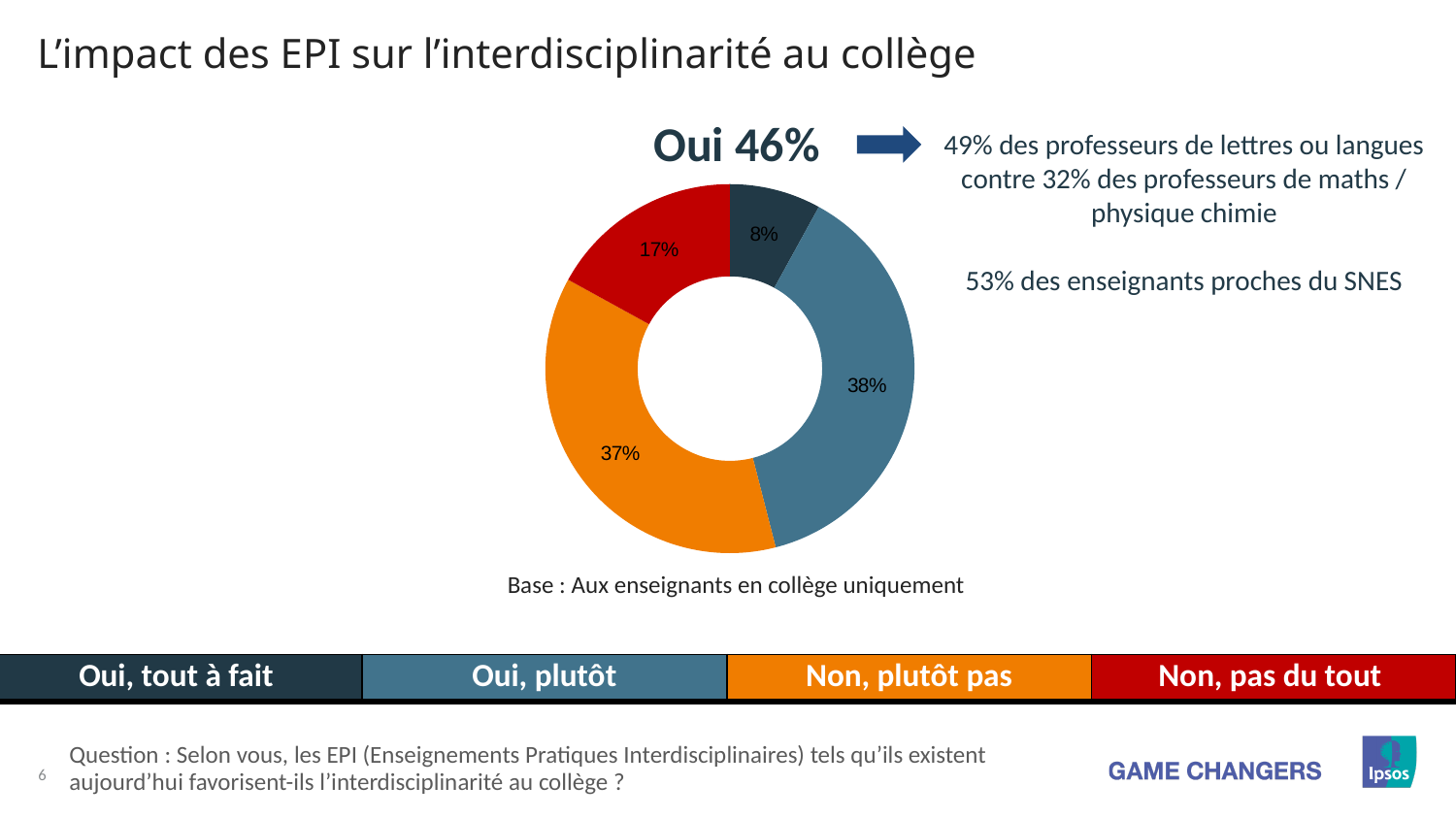
What colour represents "Non, plutôt pas" in the chart? Orange What kind of chart is shown on the slide? Pie chart (donut) What percentage of respondents answered "Non, plutôt pas"? 37% Which is larger: the share for "Non, pas du tout" or the share for "Oui, tout à fait"? Non, pas du tout What percentage of respondents answered "Non, pas du tout"? 17% Which response category has the smallest share of the pie? Oui, tout à fait What percentage of respondents answered "Oui, tout à fait"? 8% How many slices does the pie chart have? 4 What is the combined share of the two "Oui" responses shown above the chart? 46% What percentage of respondents answered "Oui, plutôt"? 38% Which response category has the largest share of the pie? Oui, plutôt What is the difference between the "Non, pas du tout" share and the "Oui, tout à fait" share? 9 percentage points